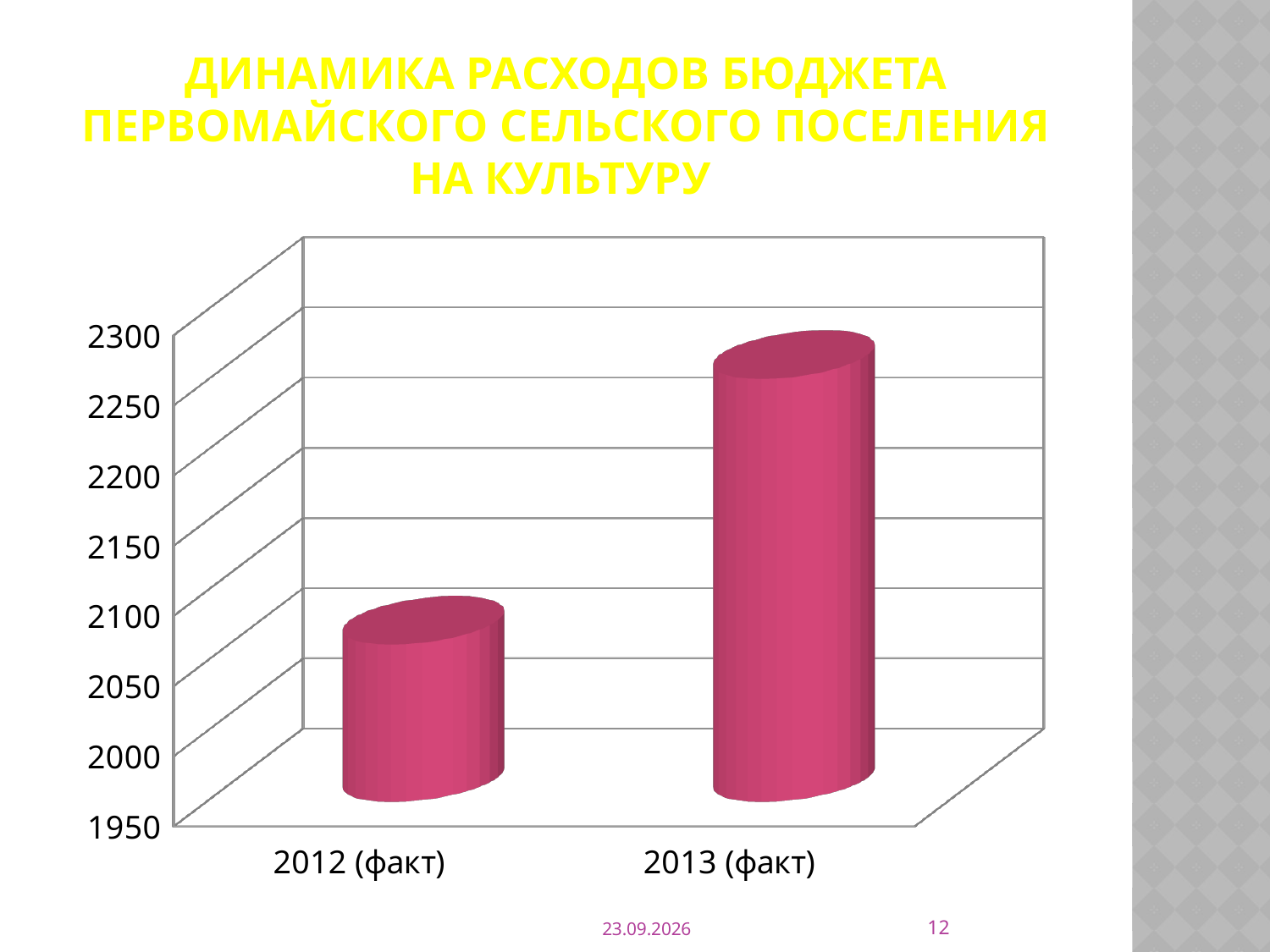
Which is larger, the value for 2012 (факт) or the value for 2013 (факт)? 2013 (факт) Is the value for 2013 (факт) greater or less than 2100? greater How many categories are shown on the x axis of the chart? 2 What is the lowest value shown on the vertical axis of the chart? 1950 What kind of chart is shown on the slide? bar chart Is the value for 2012 (факт) greater or less than 2000? greater Is the value for 2012 (факт) greater or less than 2150? less What is the title of the chart on the slide? ДИНАМИКА РАСХОДОВ БЮДЖЕТА ПЕРВОМАЙСКОГО СЕЛЬСКОГО ПОСЕЛЕНИЯ НА КУЛЬТУРУ Which category has the highest value in the chart? 2013 (факт) Do the values rise or fall from 2012 (факт) to 2013 (факт)? rise Which category has the lowest value in the chart? 2012 (факт)